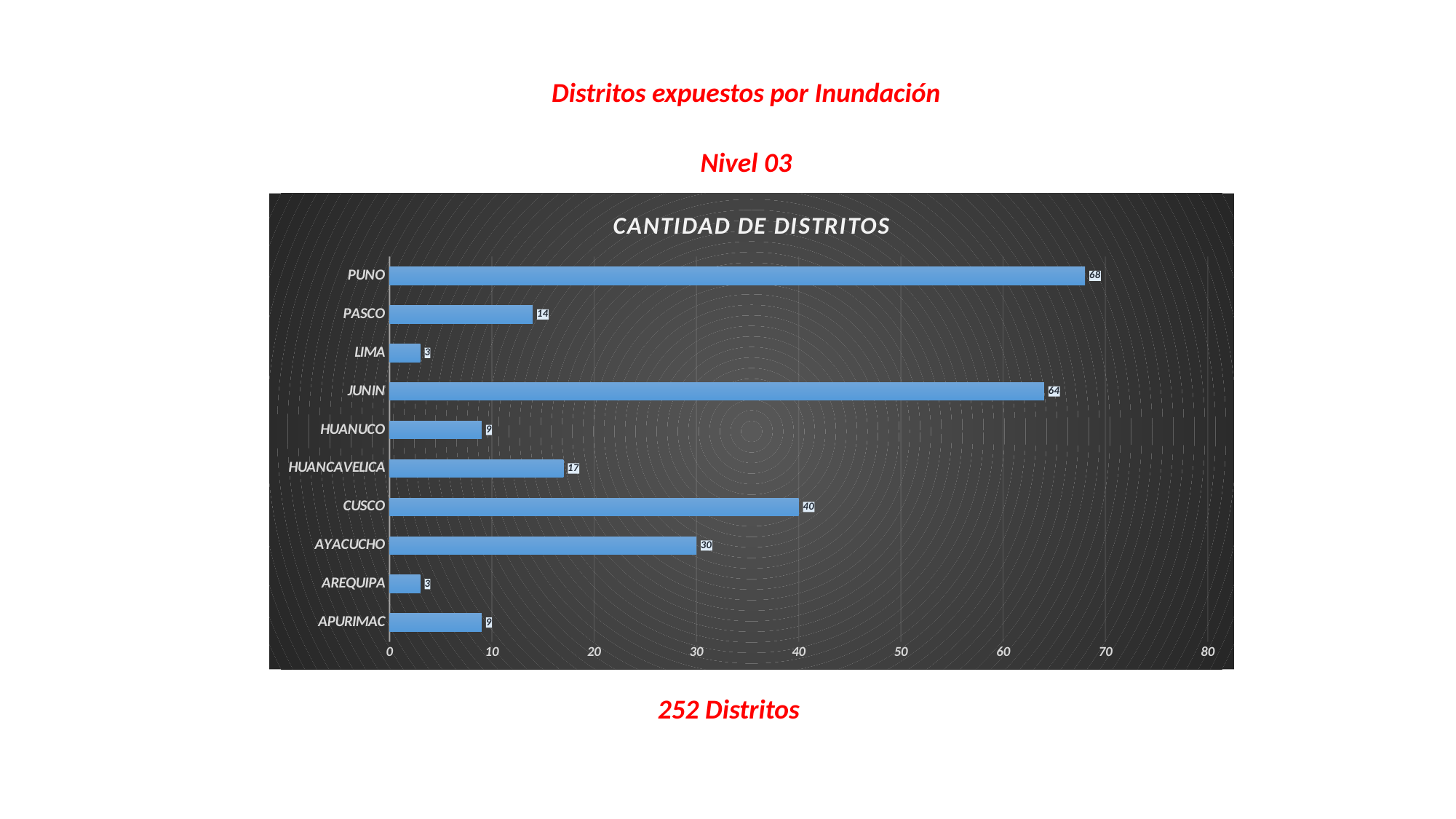
What kind of chart is shown? bar chart Is the value for JUNIN greater or less than 60? greater What is the value for AYACUCHO? 30 What is the value for CUSCO? 40 What is the difference between the values for PUNO and JUNIN? 4 Which is larger, the value for PASCO or the value for HUANUCO? PASCO What is the difference between the values for CUSCO and AYACUCHO? 10 What is the value for HUANCAVELICA? 17 Which category has the highest value? PUNO What is the title of the chart? CANTIDAD DE DISTRITOS What is the value for PUNO? 68 How many categories are shown in the chart? 10